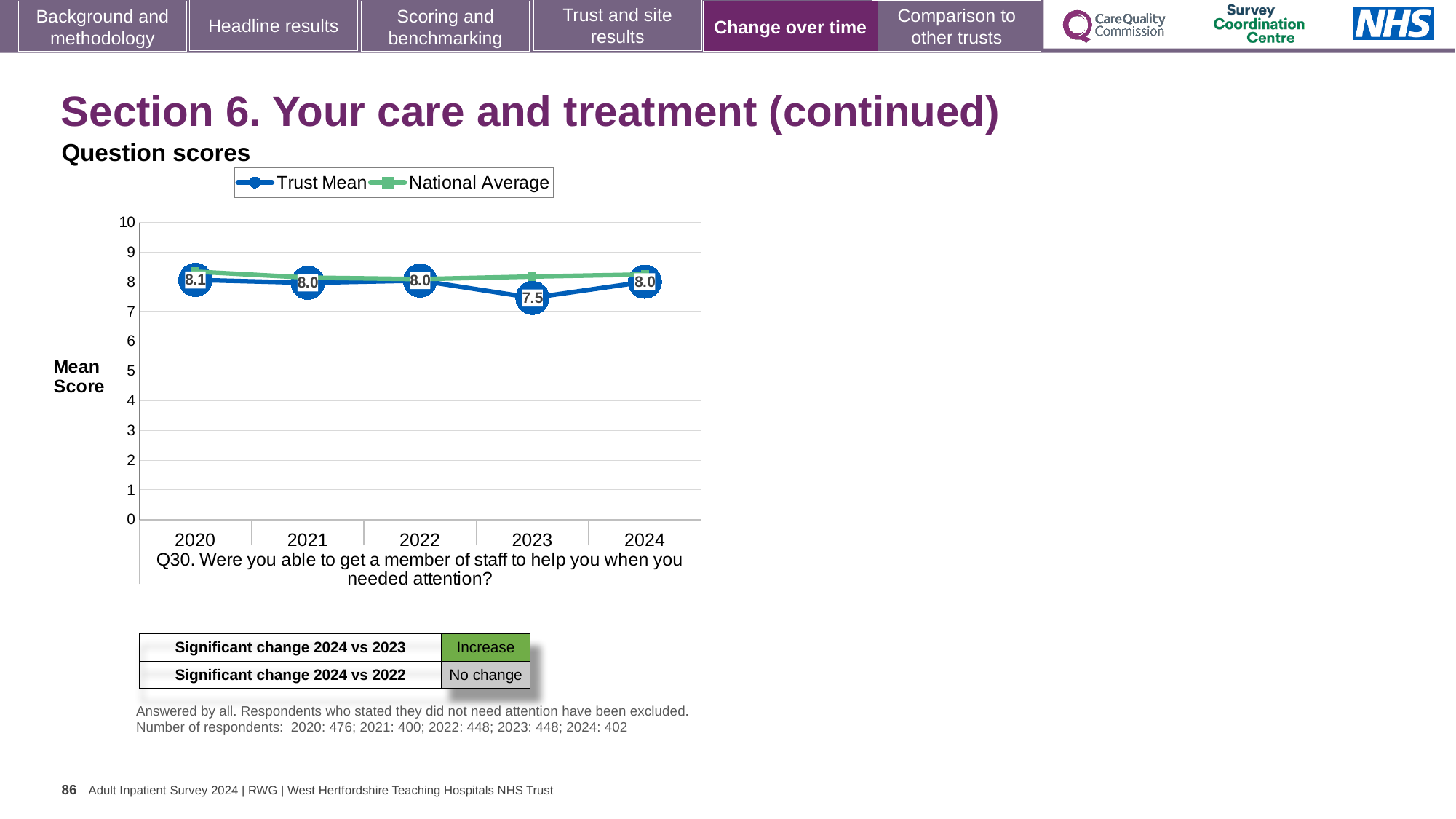
In which year is the Trust Mean score highest? 2020 How many series does the legend list? 2 How many years are shown on the x axis? 5 What is the Trust Mean score for 2024? 8.0 In which year is the Trust Mean score lowest? 2023 Is the National Average for 2023 greater or less than 7? greater Does the Trust Mean rise or fall from 2023 to 2024? Rise What is the difference between the Trust Mean scores for 2024 and 2023? 0.5 In 2023, which is higher: the Trust Mean or the National Average? National Average What is the Trust Mean score for 2023? 7.5 What is the Trust Mean score for 2020? 8.1 What kind of chart is shown? Line chart